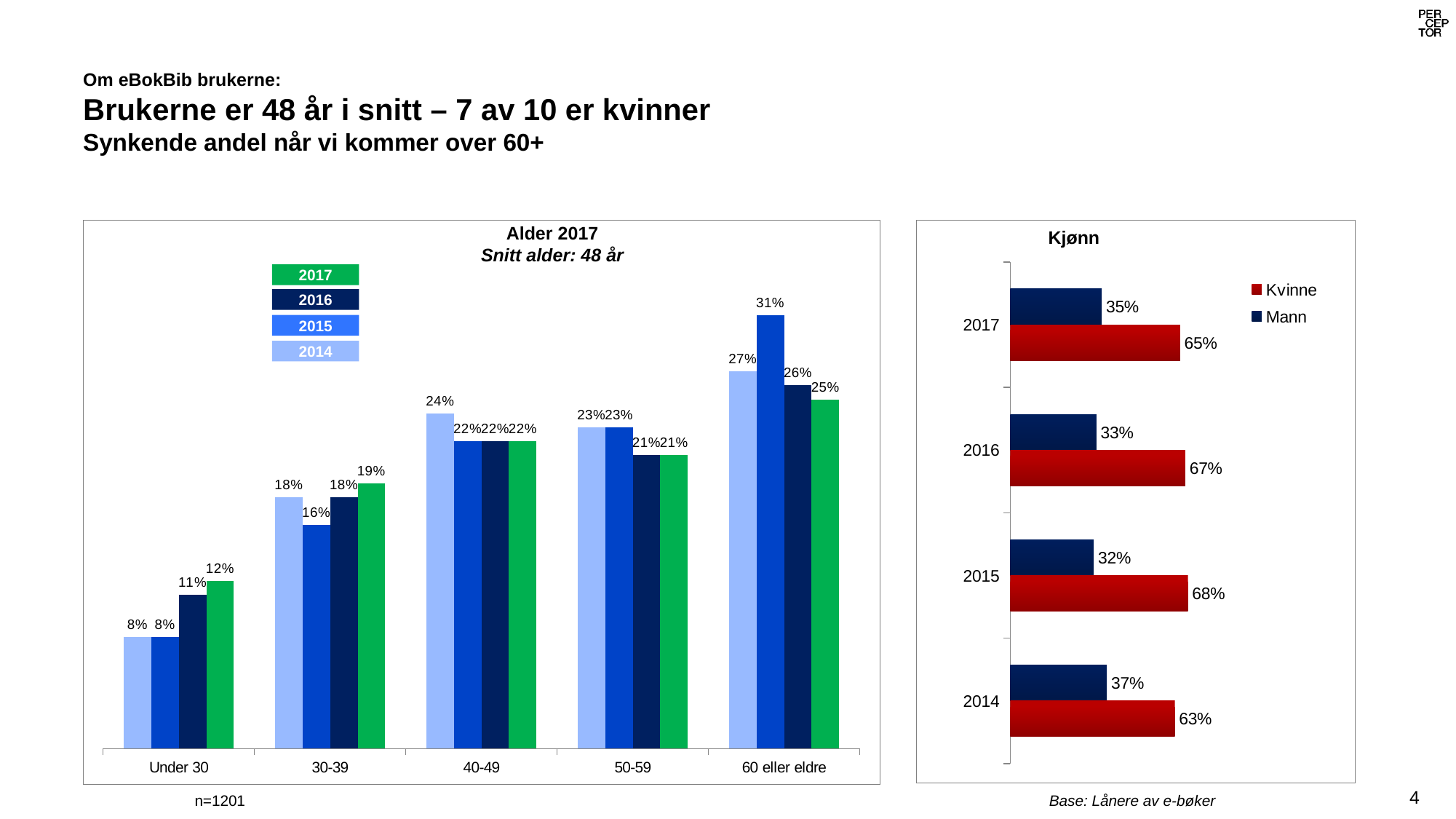
In the 'Alder 2017' chart, what is the value for 2015 in the '30-39' category? 16% What kind of chart is the 'Kjønn' chart? Bar chart In the 'Alder 2017' chart, how many series does the legend list? 4 In the 'Kjønn' chart, what is the value for Mann in 2014? 37% In the 'Alder 2017' chart, how many age categories are shown on the x axis? 5 In the 'Alder 2017' chart, which age category has the lowest value for the 2017 series? Under 30 In the 'Kjønn' chart, what is the value for Kvinne in 2015? 68% In the 'Kjønn' chart, what is the difference between Kvinne and Mann in 2017? 30% In the 'Alder 2017' chart, what is the difference between the 2015 and 2017 values in the '60 eller eldre' category? 6% In the 'Kjønn' chart, which year has the highest value for Mann? 2014 In the 'Alder 2017' chart, which age category has the highest value for the 2015 series? 60 eller eldre In the 'Alder 2017' chart, what is the value for 2017 in the '60 eller eldre' category? 25%